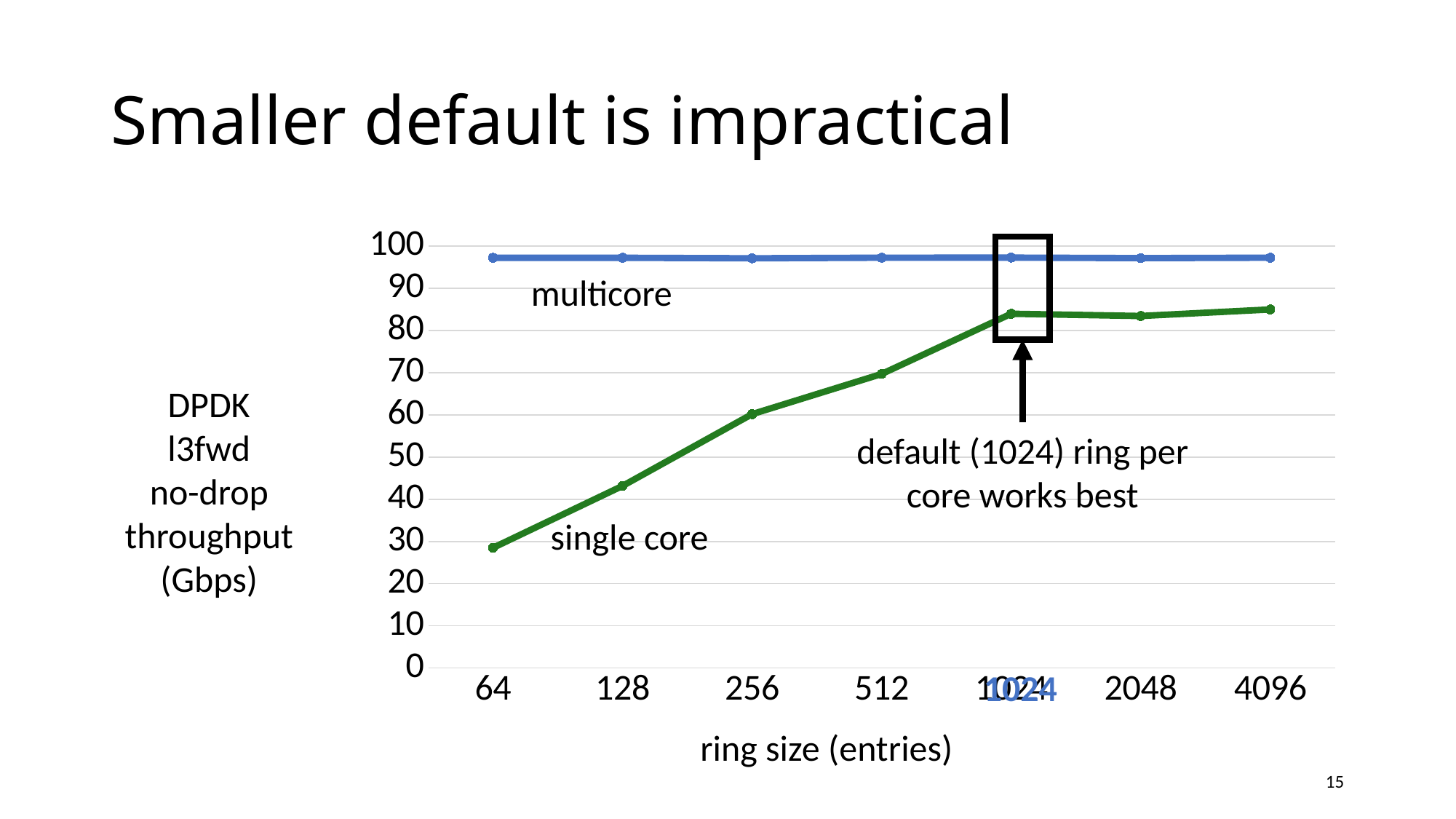
Does the single core throughput rise or fall as ring size increases from 64 to 1024? rise How many data series are plotted on the chart? 2 Is the single core throughput at ring size 256 greater or less than 50? greater Is the single core throughput at ring size 512 greater or less than 80? less At which ring size is the single core throughput lowest? 64 Which ring size is highlighted by the box and arrow as the default that works best? 1024 Which series has the higher throughput at ring size 128, multicore or single core? multicore Is the multicore throughput at ring size 512 greater or less than 90? greater What is the label of the x axis? ring size (entries) What kind of chart is shown on the slide? line chart How many ring size values are plotted along the x axis? 7